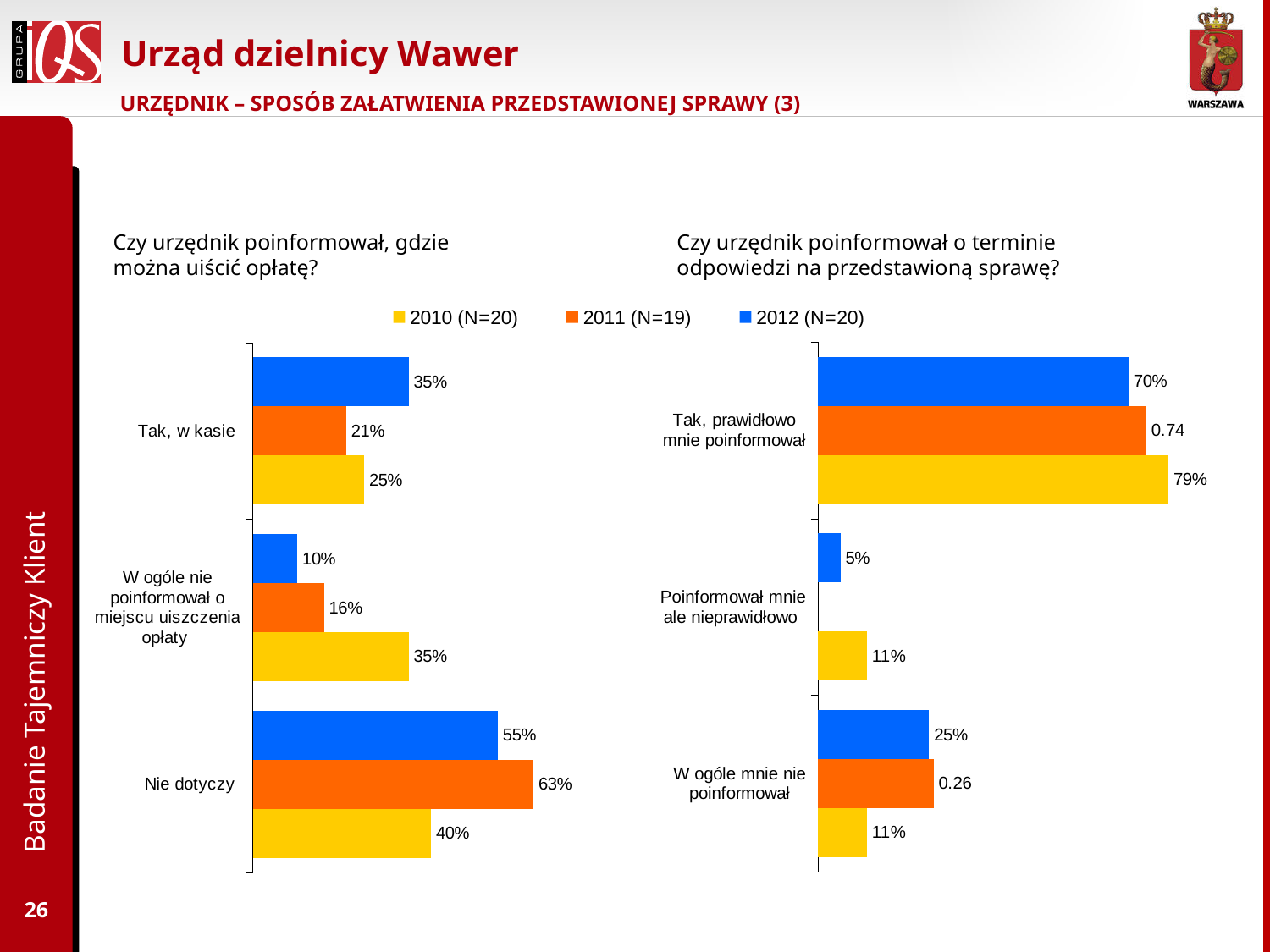
In the left chart (Czy urzędnik poinformował, gdzie można uiścić opłatę?), what is the value for 'Nie dotyczy' in 2011 (N=19)? 63% In the right chart (Czy urzędnik poinformował o terminie odpowiedzi na przedstawioną sprawę?), what is the difference between the 2012 and 2010 values for 'W ogóle mnie nie poinformował'? 14% In the left chart (Czy urzędnik poinformował, gdzie można uiścić opłatę?), which is larger for 'Tak, w kasie': the 2010 value or the 2011 value? 2010 In the right chart (Czy urzędnik poinformował o terminie odpowiedzi na przedstawioną sprawę?), which category has the lowest value for 2012 (N=20)? Poinformował mnie ale nieprawidłowo In the left chart (Czy urzędnik poinformował, gdzie można uiścić opłatę?), which category has the highest value for 2012 (N=20)? Nie dotyczy How many series does the legend list? 3 In the left chart (Czy urzędnik poinformował, gdzie można uiścić opłatę?), what is the value for 'Tak, w kasie' in 2012 (N=20)? 35% What kind of chart is the left chart (Czy urzędnik poinformował, gdzie można uiścić opłatę?)? Bar chart In the right chart (Czy urzędnik poinformował o terminie odpowiedzi na przedstawioną sprawę?), what label is shown for 'W ogóle mnie nie poinformował' in 2011 (N=19)? 0.26 In the left chart (Czy urzędnik poinformował, gdzie można uiścić opłatę?), what is the difference between the 2010 and 2012 values for 'W ogóle nie poinformował o miejscu uiszczenia opłaty'? 25% How many categories are shown in the right chart (Czy urzędnik poinformował o terminie odpowiedzi na przedstawioną sprawę?)? 3 In the right chart (Czy urzędnik poinformował o terminie odpowiedzi na przedstawioną sprawę?), what is the value for 'Tak, prawidłowo mnie poinformował' in 2010 (N=20)? 79%